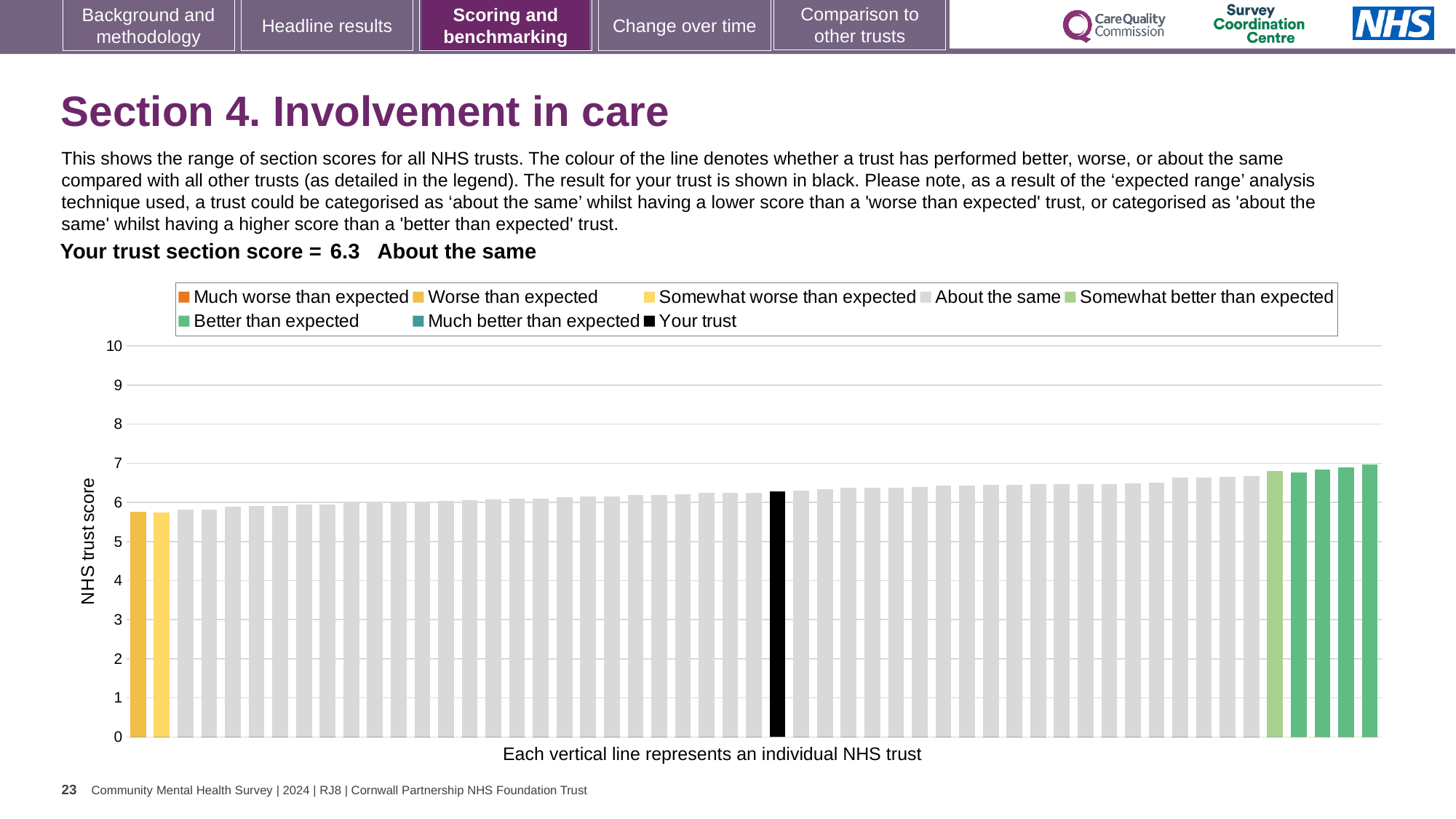
Is the value for the rightmost bar greater or less than 6? greater Is the value for the leftmost bar greater or less than 5? greater Which bar has the highest value, the leftmost or the rightmost? rightmost How many entries does the chart legend list? 8 What is the label on the vertical axis of the chart? NHS trust score Is the value for the black bar (your trust) greater or less than 7? less What colour is the bar representing your trust? black Do the bar values rise or fall moving from left to right along the x axis? rise What kind of chart is shown on the slide? bar chart What is the section score for your trust shown on the slide? 6.3 Which category is your trust placed in for this section? About the same